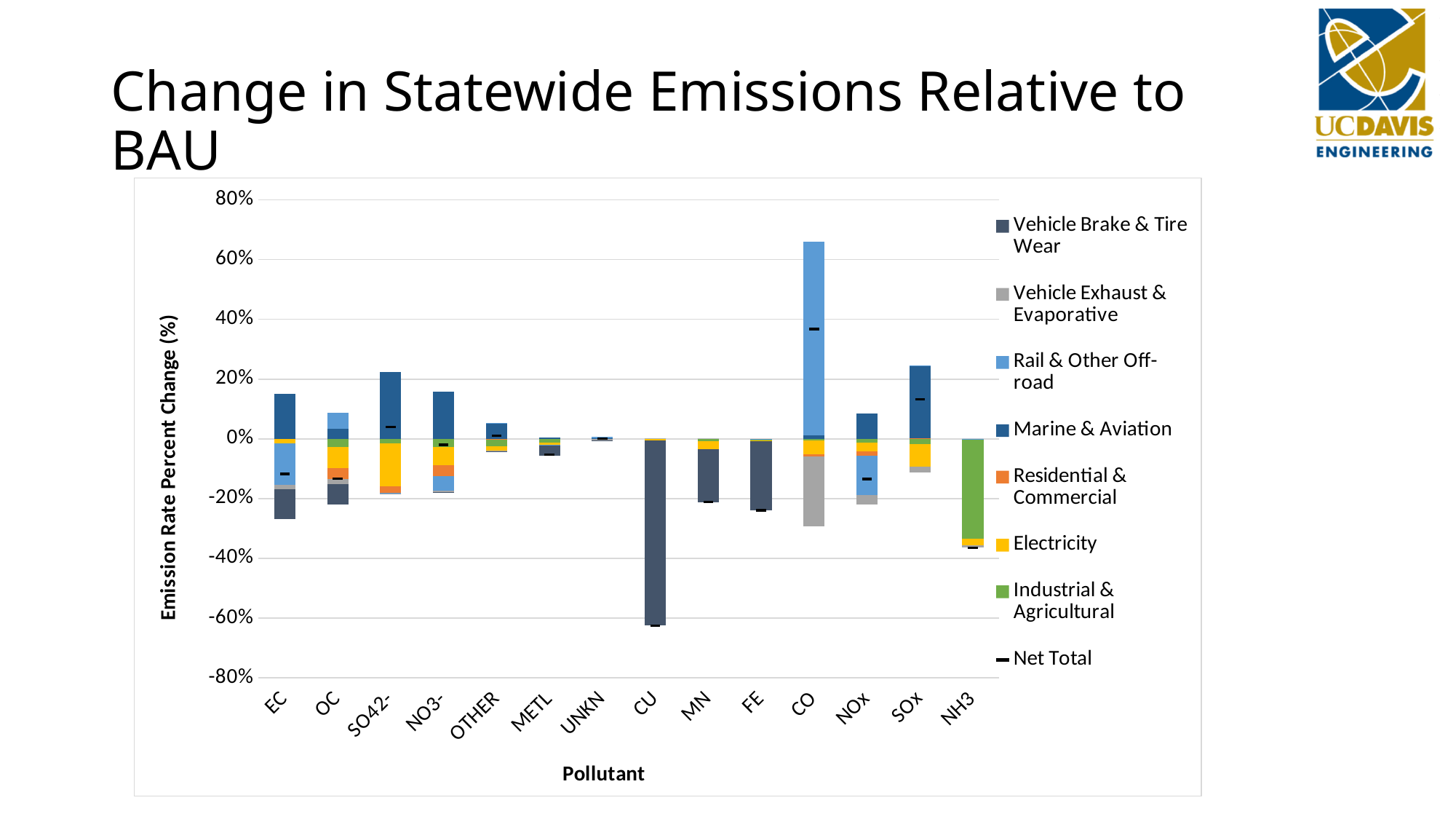
Which has the larger Net Total, CO or SOx? CO What is the label of the y axis? Emission Rate Percent Change (%) Which pollutant has the highest Net Total marker? CO How many pollutant categories are shown on the x axis? 14 Is the Vehicle Brake & Tire Wear value for CU greater or less than -40%? less Is the Rail & Other Off-road value for CO greater or less than 60%? greater How many entries does the legend list? 8 What is the title of the chart? Change in Statewide Emissions Relative to BAU Which pollutant has the lowest (most negative) stacked bar? CU Is the Net Total for CO greater or less than 20%? greater Which pollutant has the tallest positive stacked bar? CO What kind of chart is shown on the slide? Stacked bar chart